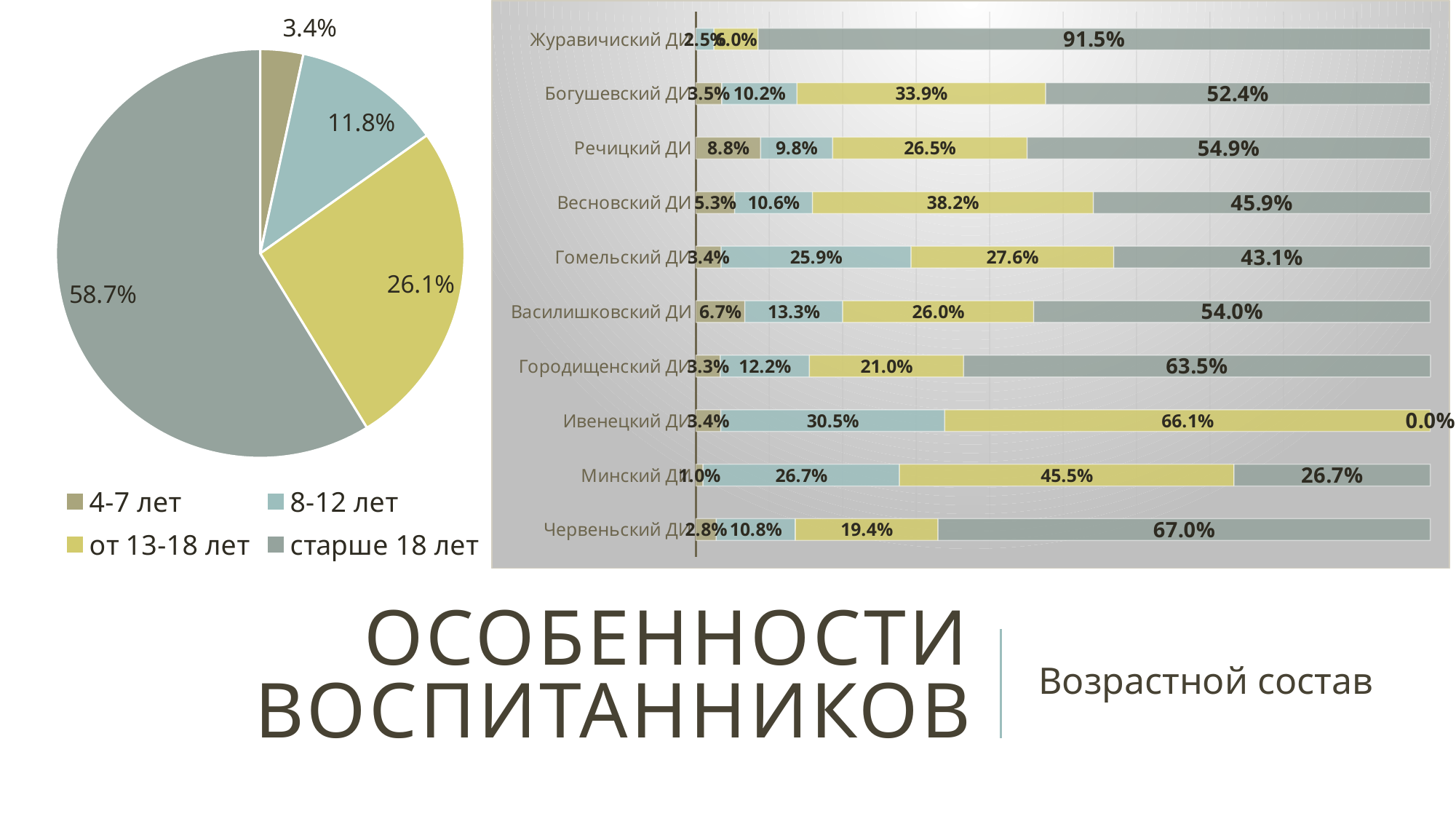
In the bar chart on the right, which institution has the lowest 'старше 18 лет' value? Ивенецкий ДИ In the pie chart on the left, what share does the 'старше 18 лет' slice have? 58.7% In the pie chart on the left, which age group has the smallest slice? 4-7 лет In the bar chart on the right, what is the 'от 13-18 лет' value for Минский ДИ? 45.5% In the bar chart on the right, how many institutions (categories) are shown? 10 What kind of chart is the chart on the right of the slide? bar chart In the pie chart on the left, what is the difference between the 'от 13-18 лет' slice and the '8-12 лет' slice? 14.3 percentage points In the bar chart on the right, which institution has the highest 'старше 18 лет' value? Журавичиский ДИ What kind of chart is the chart on the left of the slide? pie chart In the bar chart on the right, what is the value for 'старше 18 лет' at Журавичиский ДИ? 91.5% In the bar chart on the right, which has the larger '8-12 лет' value: Гомельский ДИ or Весновский ДИ? Гомельский ДИ How many series does the legend list? 4